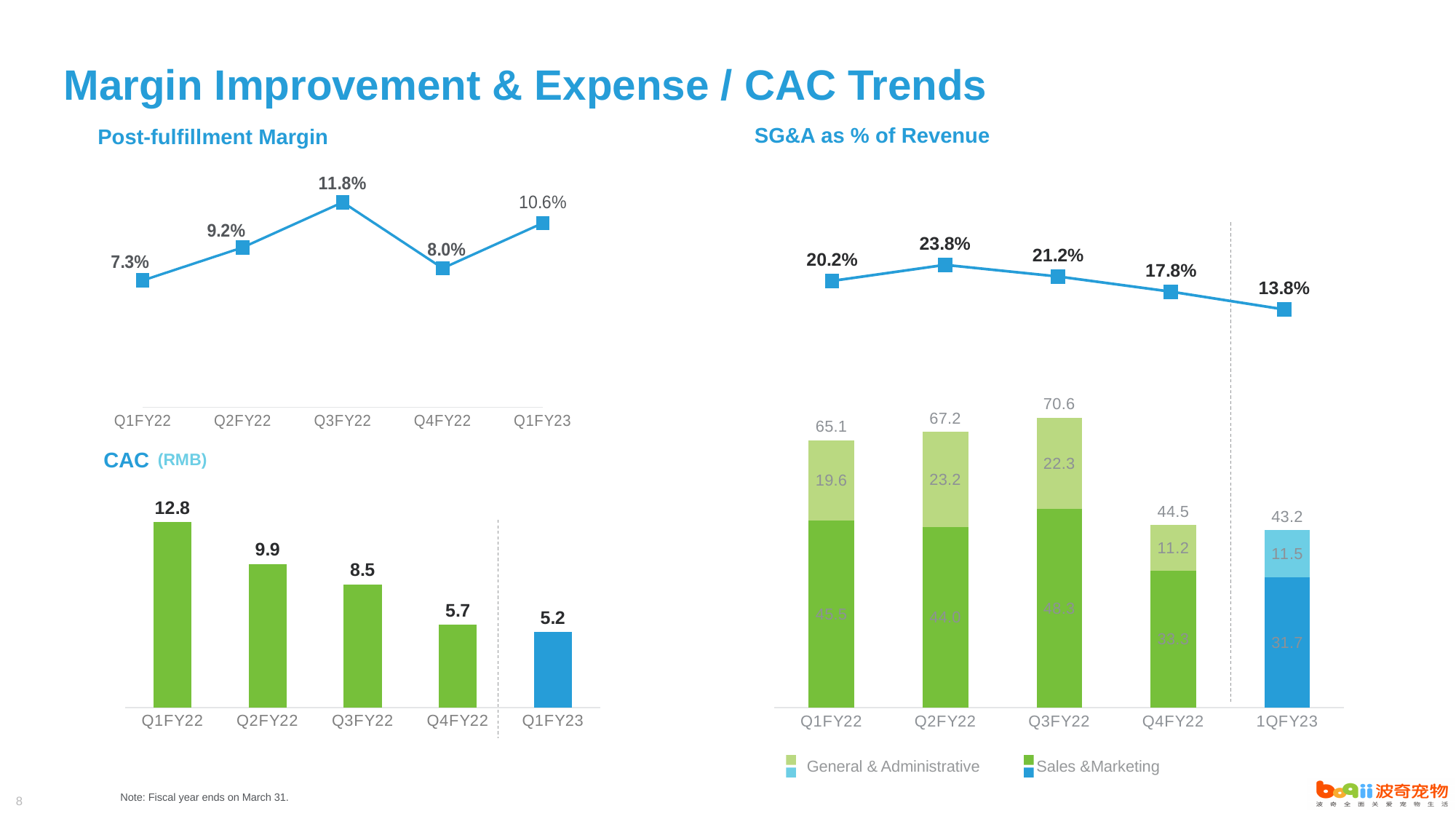
In the SG&A as % of Revenue chart, what is the total of the stacked bar for Q4FY22? 44.5 In the CAC chart, which quarter has the highest CAC? Q1FY22 In the CAC chart, do the values rise or fall from Q1FY22 to Q1FY23? fall In the SG&A as % of Revenue chart, which is larger: the General & Administrative value for Q2FY22 or for Q4FY22? Q2FY22 How many series does the legend of the SG&A as % of Revenue chart list? 2 In the Post-fulfillment Margin chart, which quarter has the lowest margin? Q1FY22 In the CAC chart, what is the value for Q1FY23? 5.2 In the SG&A as % of Revenue chart, what is the Sales & Marketing value for Q3FY22? 48.3 In the Post-fulfillment Margin chart, what is the value for Q3FY22? 11.8% In the SG&A as % of Revenue chart, what is the SG&A percentage for Q2FY22? 23.8% In the Post-fulfillment Margin chart, what is the difference between Q3FY22 and Q4FY22? 3.8% What kind of chart is the CAC chart? bar chart